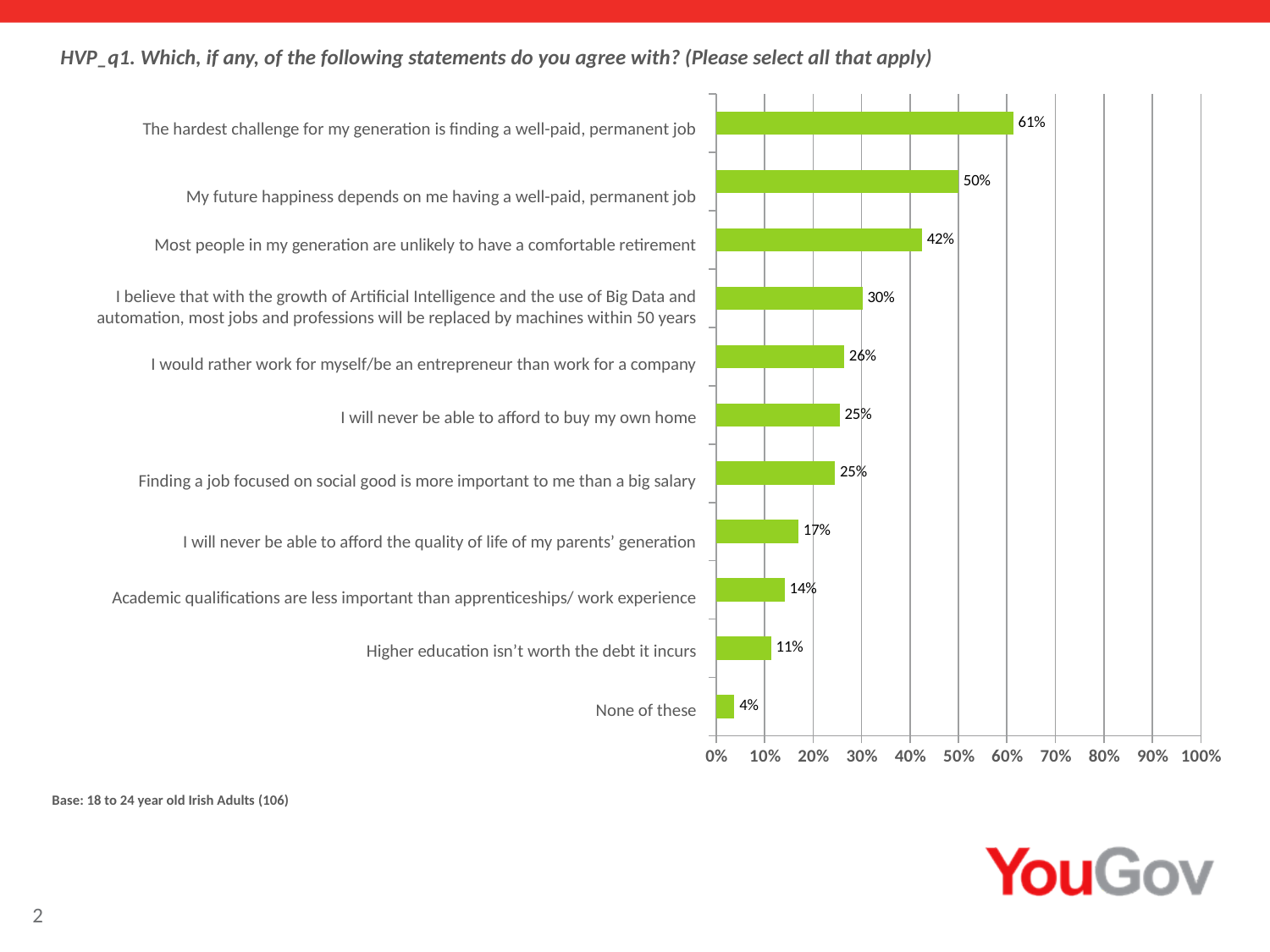
What percentage agreed that the hardest challenge for their generation is finding a well-paid, permanent job? 61% What percentage agreed that higher education isn't worth the debt it incurs? 11% Is the value for 'I believe that with the growth of Artificial Intelligence and the use of Big Data and automation, most jobs and professions will be replaced by machines within 50 years' greater or less than 20%? greater What percentage agreed that most people in their generation are unlikely to have a comfortable retirement? 42% Which statement has the highest level of agreement? The hardest challenge for my generation is finding a well-paid, permanent job What type of chart is shown on the slide? Bar chart What is the difference between the percentage agreeing that their future happiness depends on having a well-paid, permanent job and the percentage agreeing that academic qualifications are less important than apprenticeships/work experience? 36% Which category has the lowest value? None of these What percentage selected 'None of these'? 4% Which has a higher value: 'I would rather work for myself/be an entrepreneur than work for a company' or 'I will never be able to afford the quality of life of my parents' generation'? I would rather work for myself/be an entrepreneur than work for a company How many statements (categories) are shown in the chart? 11 What is the base (sample) described below the chart? 18 to 24 year old Irish Adults (106)